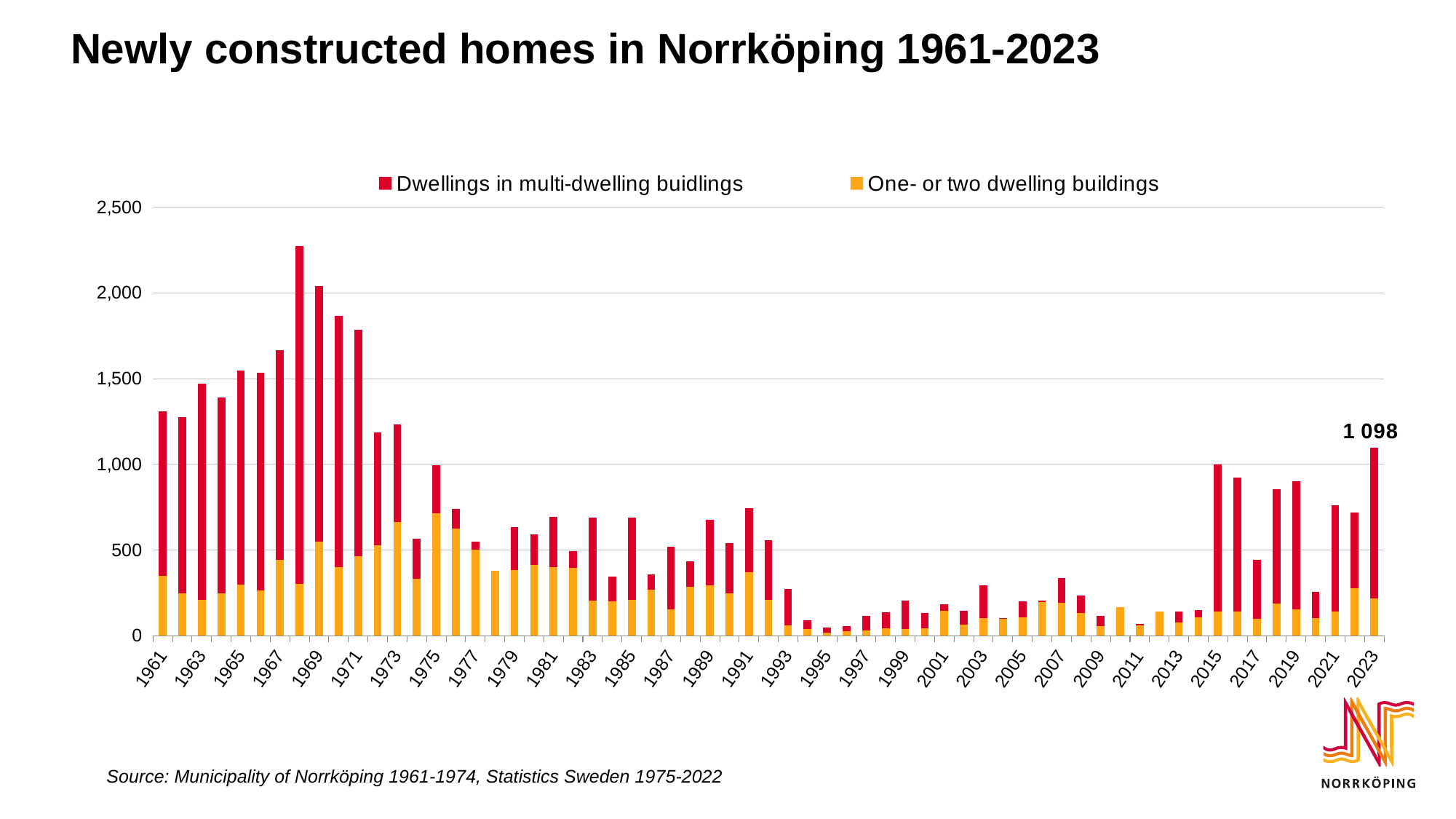
Is the total value for 1961 greater or less than 1,000? greater Which year has the larger total bar, 2016 or 2018? 2016 What is the total number of newly constructed homes shown for 2023? 1 098 Is the total value for 1994 greater or less than 500? less Is the total value for 1968 greater or less than 2,000? greater Which year has the larger total bar, 1968 or 2023? 1968 What kind of chart is shown on the slide? bar chart Which year has the highest total bar? 1968 How many series does the legend list? 2 Do the total values rise or fall from 1968 to 1975? fall Which series is shown in red? Dwellings in multi-dwelling buidlings